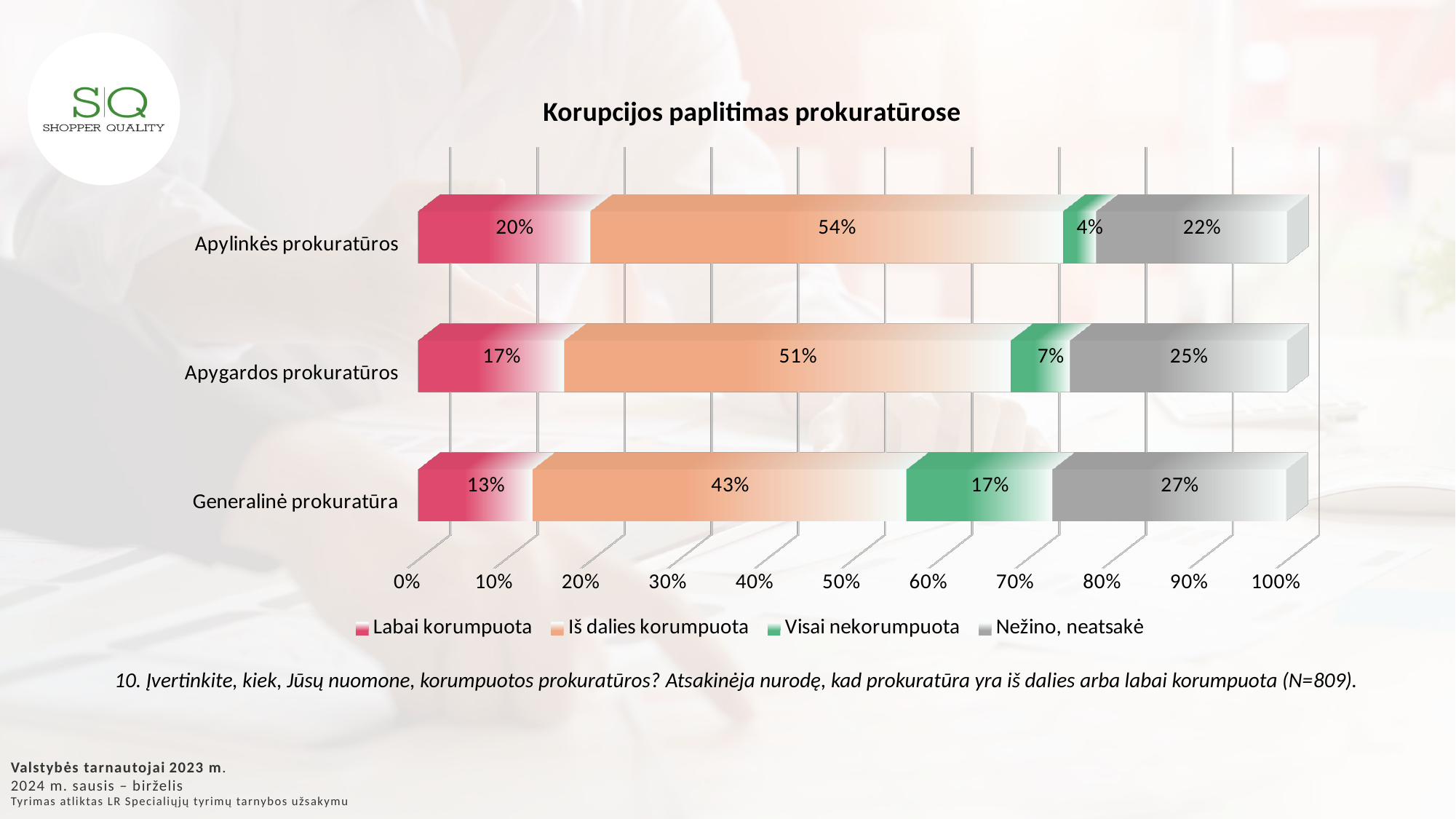
What is the value for "Nežino, neatsakė" for Apygardos prokuratūros? 25% Which category has the highest value for "Visai nekorumpuota"? Generalinė prokuratūra How many series does the legend list? 4 Which category has the lowest value for "Labai korumpuota"? Generalinė prokuratūra What kind of chart is shown on the slide? Stacked bar chart What is the value for "Labai korumpuota" for Apylinkės prokuratūros? 20% What is the total of the stacked bar for Apygardos prokuratūros? 100% What is the difference between the "Iš dalies korumpuota" values for Apylinkės prokuratūros and Generalinė prokuratūra? 11% How many categories are shown on the chart? 3 Which is larger: the "Nežino, neatsakė" value for Apylinkės prokuratūros or for Generalinė prokuratūra? Generalinė prokuratūra What is the value for "Iš dalies korumpuota" for Generalinė prokuratūra? 43% What is the title of the chart? Korupcijos paplitimas prokuratūrose